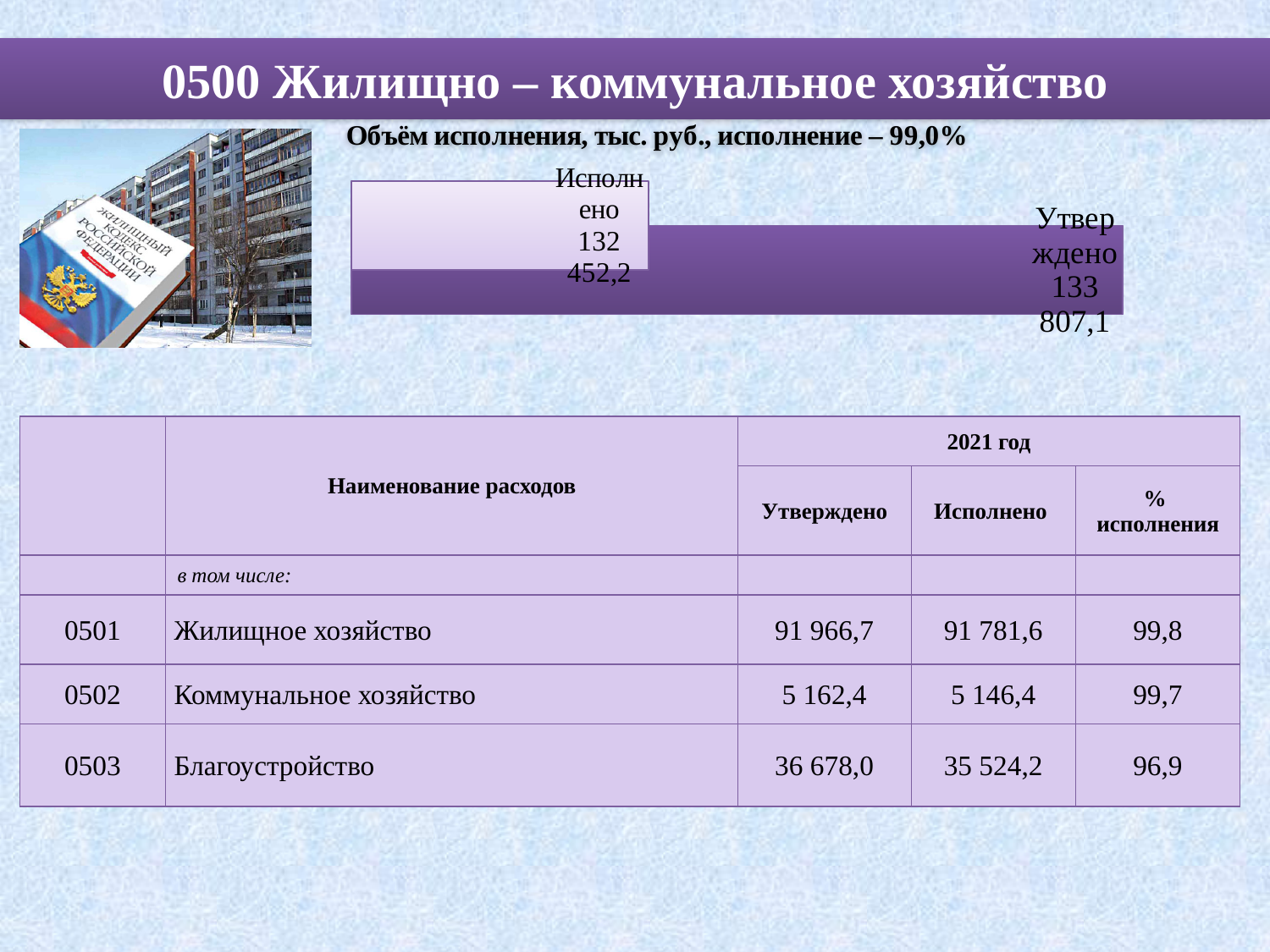
What kind of chart is shown on the slide? bar chart What value is shown for the bar labelled Утверждено? 133 807,1 Which bar has the lower value in the chart? Исполнено How many bars are plotted in the chart? 2 Is the Исполнено value larger or smaller than the Утверждено value? smaller What is the difference between the Утверждено value and the Исполнено value? 1 354,9 Which bar has the higher value, Исполнено or Утверждено? Утверждено What execution percentage is stated in the chart title? 99,0% What is the title of the chart? Объём исполнения, тыс. руб., исполнение – 99,0% What value is shown for the bar labelled Исполнено? 132 452,2